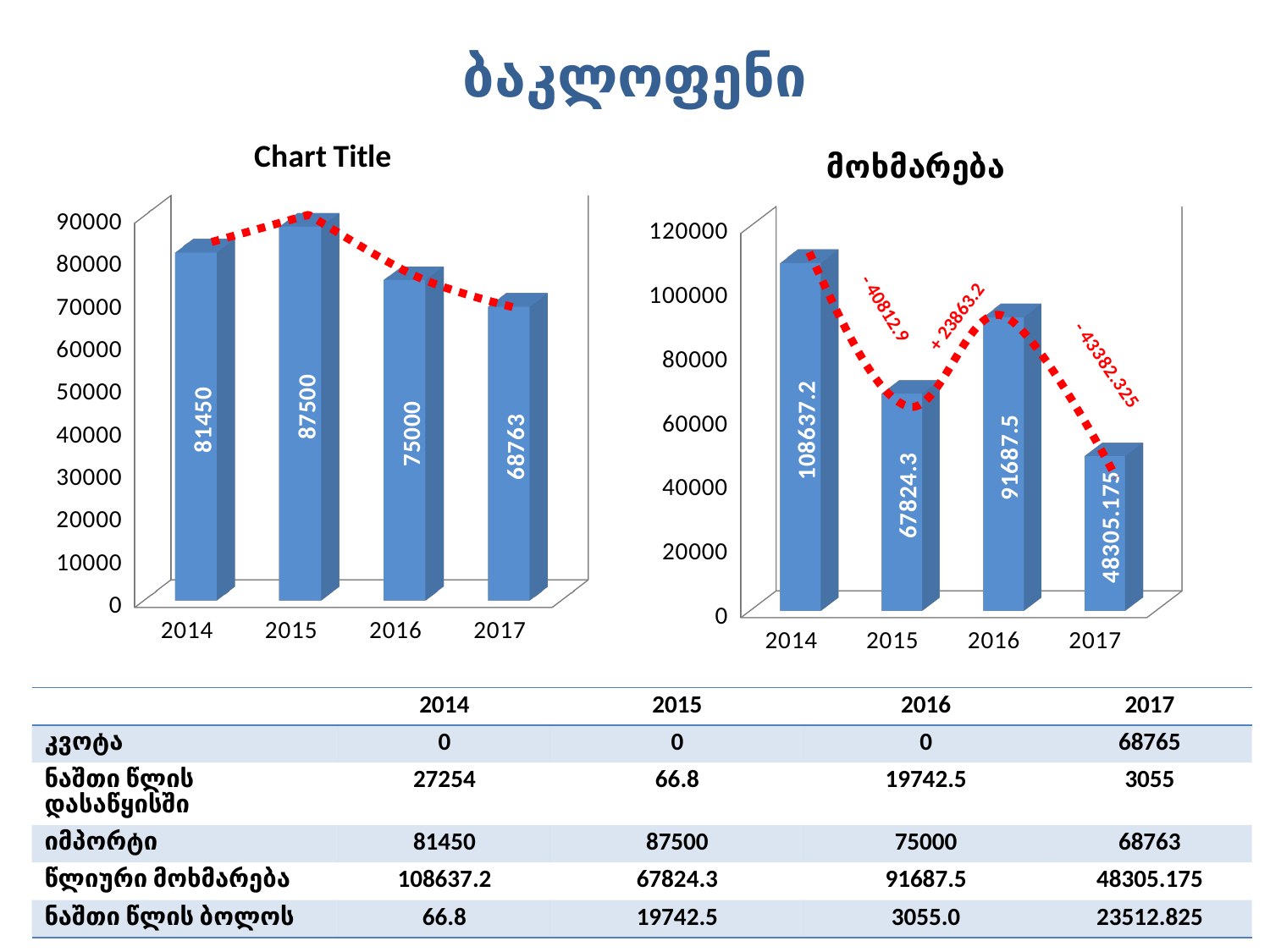
In the right chart titled "მოხმარება", which year has the lowest value? 2017 What kind of chart is the left chart titled "Chart Title"? bar chart In the left chart titled "Chart Title", what is the difference between the 2015 and 2016 values? 12500 In the right chart titled "მოხმარება", which is larger, the value for 2015 or the value for 2016? 2016 In the right chart titled "მოხმარება", what is the value for 2017? 48305.175 How many years are shown on the x axis of the right chart titled "მოხმარება"? 4 In the right chart titled "მოხმარება", what is the value for 2014? 108637.2 In the left chart titled "Chart Title", which year has the lowest value? 2017 In the left chart titled "Chart Title", what is the value for 2017? 68763 In the right chart titled "მოხმარება", is the value for 2014 greater or less than 100000? greater In the left chart titled "Chart Title", what is the value for 2015? 87500 In the left chart titled "Chart Title", which year has the highest value? 2015